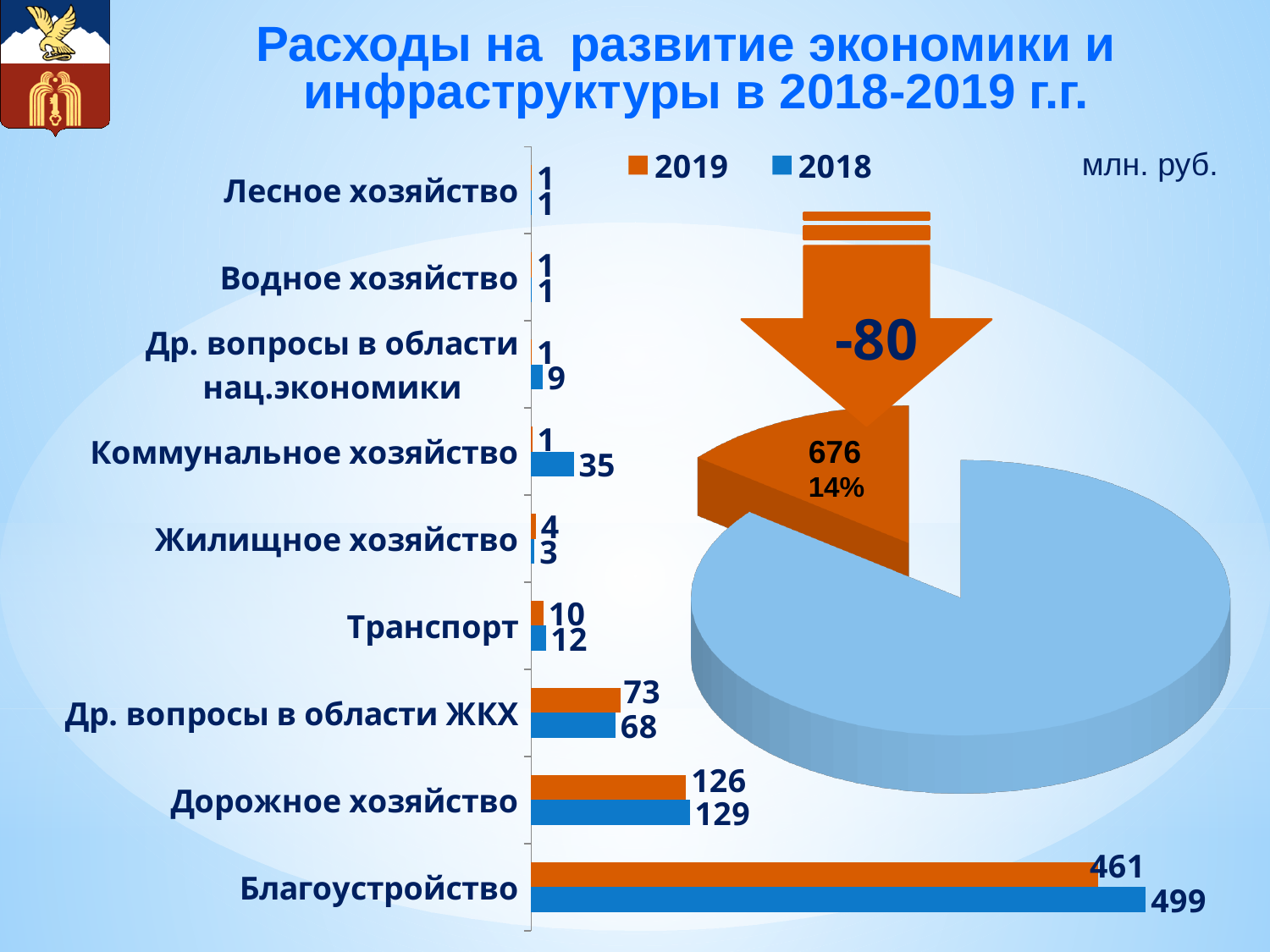
In the bar chart, which category has the highest 2018 value? Благоустройство In the bar chart, what is the 2018 value for Дорожное хозяйство? 129 In the bar chart, what is the 2018 value for Коммунальное хозяйство? 35 In the bar chart, what is the difference between the 2018 and 2019 values for Благоустройство? 38 How many series does the bar chart legend list? 2 In the bar chart, what is the difference between the 2019 and 2018 values for Др. вопросы в области ЖКХ? 5 In the bar chart, which is larger for Жилищное хозяйство: the 2019 value or the 2018 value? 2019 In the bar chart, which is larger for Транспорт: the 2019 value or the 2018 value? 2018 What kind of chart is the chart on the left side of the slide? bar chart In the pie chart, what share does the orange slice represent? 14% In the bar chart, what is the 2019 value for Благоустройство? 461 How many categories does the bar chart show? 9